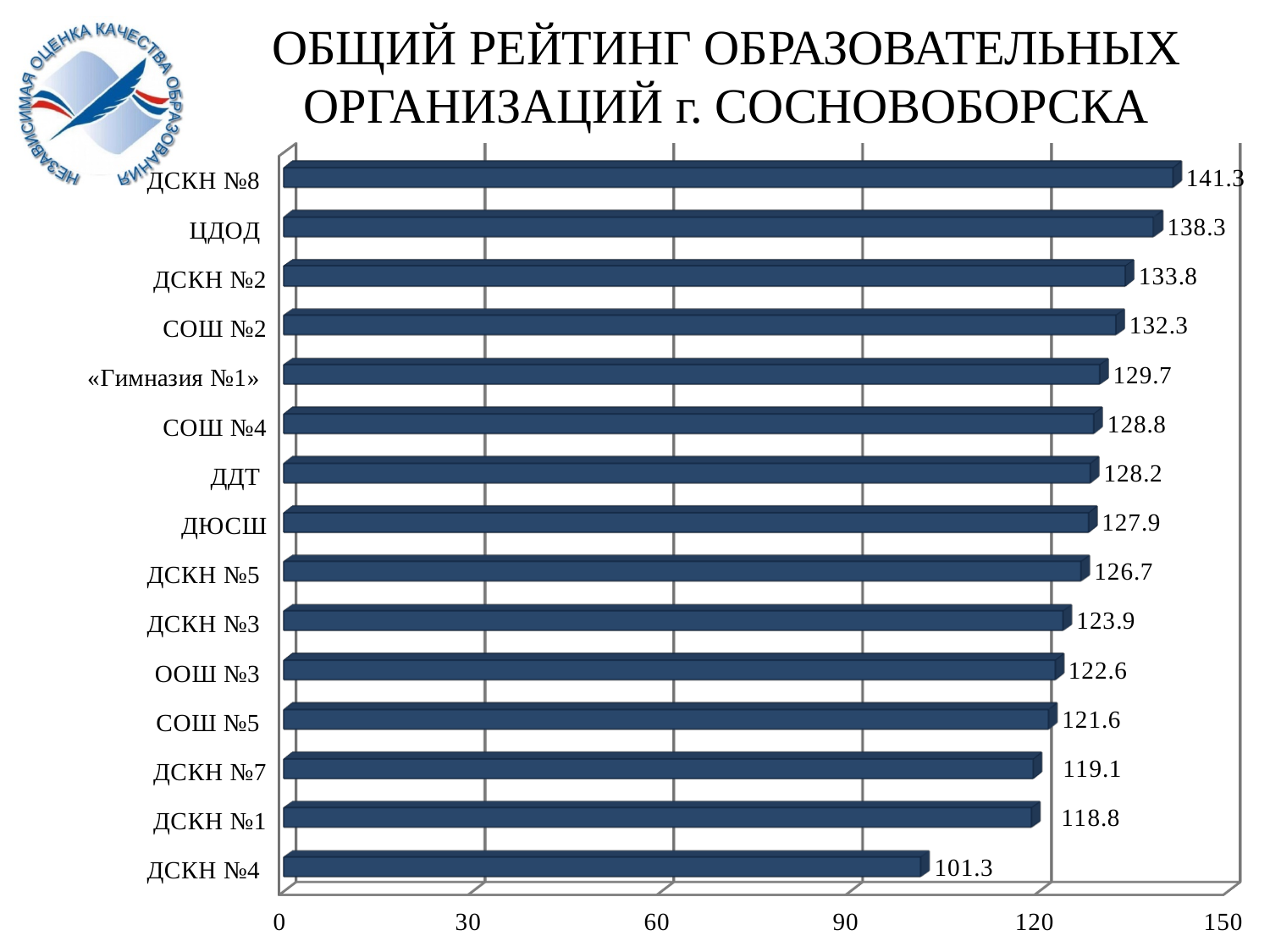
How many categories are shown in the chart? 15 Is the value for ДСКН №4 greater or less than 120? less What is the title of the chart? ОБЩИЙ РЕЙТИНГ ОБРАЗОВАТЕЛЬНЫХ ОРГАНИЗАЦИЙ г. СОСНОВОБОРСКА What is the value for ДСКН №8? 141.3 What is the value for ДСКН №4? 101.3 Which category has the lowest value? ДСКН №4 Which category has the highest value? ДСКН №8 What is the value for «Гимназия №1»? 129.7 What kind of chart is shown on the slide? bar chart Which is larger, the value for СОШ №2 or the value for СОШ №4? СОШ №2 What is the difference between the values for ЦДОД and ДСКН №2? 4.5 What is the difference between the values for ДСКН №8 and ДСКН №4? 40